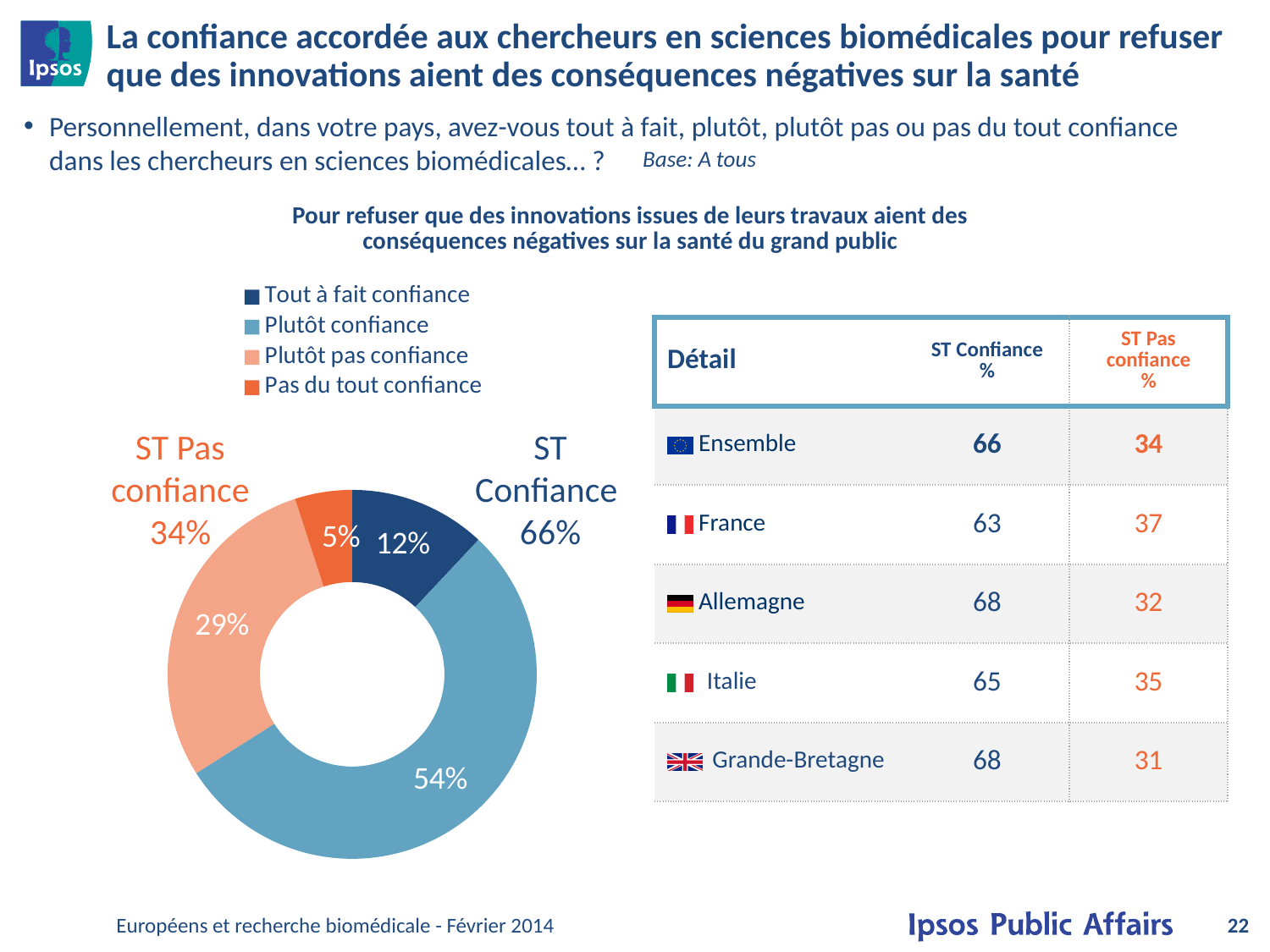
What is the combined share labelled "ST Confiance" on the chart? 66% What percentage of respondents answered "Plutôt confiance"? 54% Which response category has the smallest share of the donut chart? Pas du tout confiance What kind of chart is shown on the slide? Donut (pie) chart What is the difference between the "Plutôt confiance" share and the "Plutôt pas confiance" share? 25 percentage points What is the combined share labelled "ST Pas confiance" on the chart? 34% What percentage of respondents answered "Tout à fait confiance"? 12% What percentage of respondents answered "Pas du tout confiance"? 5% Which response category has the largest share of the donut chart? Plutôt confiance Which is larger: the share for "Tout à fait confiance" or the share for "Plutôt pas confiance"? Plutôt pas confiance What percentage of respondents answered "Plutôt pas confiance"? 29% How many slices does the donut chart have? 4